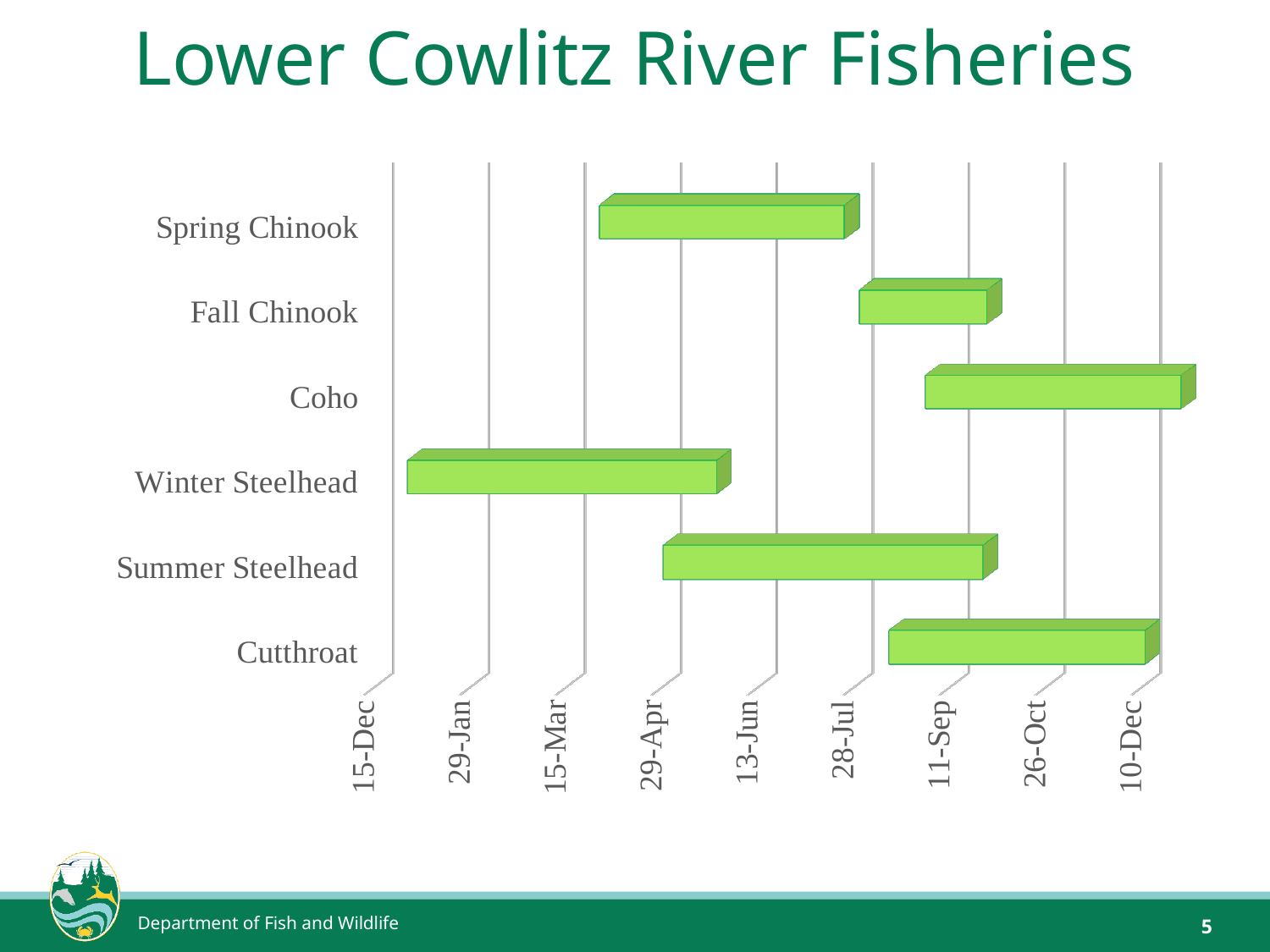
Which season starts earlier, Spring Chinook or Summer Steelhead? Spring Chinook What is the title of the chart slide? Lower Cowlitz River Fisheries Which fishery has the shortest season bar on the chart? Fall Chinook Does the Spring Chinook season end before or after 28-Jul? Before What kind of chart is shown on the slide? Bar chart Does the Coho season end before or after 26-Oct? After Does the Cutthroat season start before or after 11-Sep? Before How many fisheries (categories) are listed on the chart? 6 What is the first date label on the horizontal axis? 15-Dec